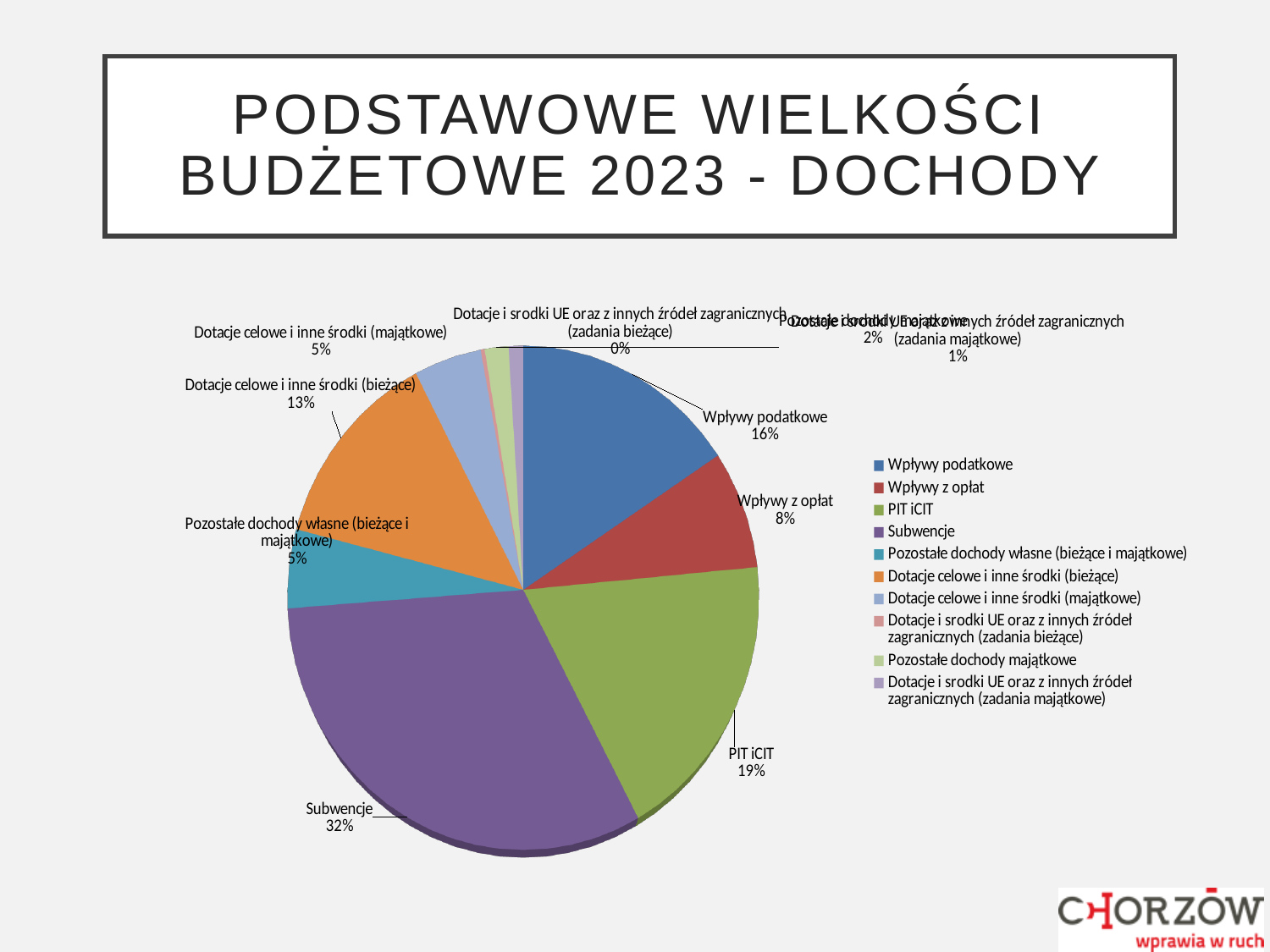
What is the title of the slide? PODSTAWOWE WIELKOŚCI BUDŻETOWE 2023 - DOCHODY What percentage is shown for Wpływy podatkowe? 16% What kind of chart is shown on the slide? Pie chart What percentage is shown for Dotacje celowe i inne środki (bieżące)? 13% How many categories does the legend list? 10 Which category has the smallest slice, shown as 0%? Dotacje i srodki UE oraz z innych źródeł zagranicznych (zadania bieżące) What percentage is shown for Wpływy z opłat? 8% What is the difference in percentage points between Subwencje and PIT iCIT? 13 Which is larger, Wpływy podatkowe or Wpływy z opłat? Wpływy podatkowe What share of the pie does Subwencje represent? 32% What percentage is shown for PIT iCIT? 19% Which category has the largest slice of the pie? Subwencje